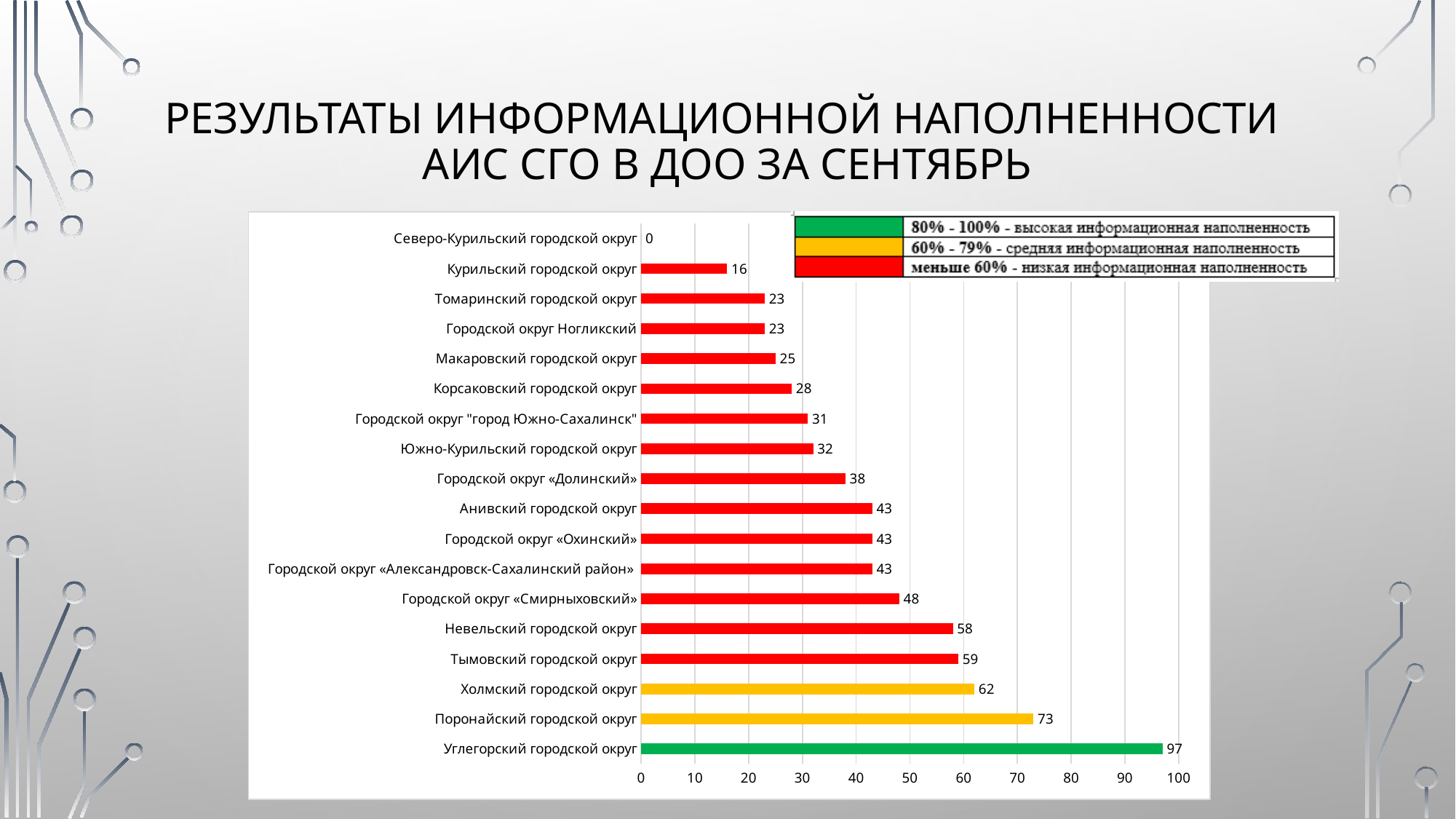
Which is larger, the value for Холмский городской округ or the value for Тымовский городской округ? Холмский городской округ What is the value for Поронайский городской округ? 73 What colour is the bar for Углегорский городской округ? Green What is the value for Городской округ «Смирныховский»? 48 What is the value for Курильский городской округ? 16 How many categories are shown in the chart? 18 What kind of chart is shown on the slide? Bar chart Which category has the lowest value? Северо-Курильский городской округ How many bars are coloured yellow? 2 What is the value for Углегорский городской округ? 97 Which category has the highest value? Углегорский городской округ What is the difference between the values for Углегорский городской округ and Поронайский городской округ? 24